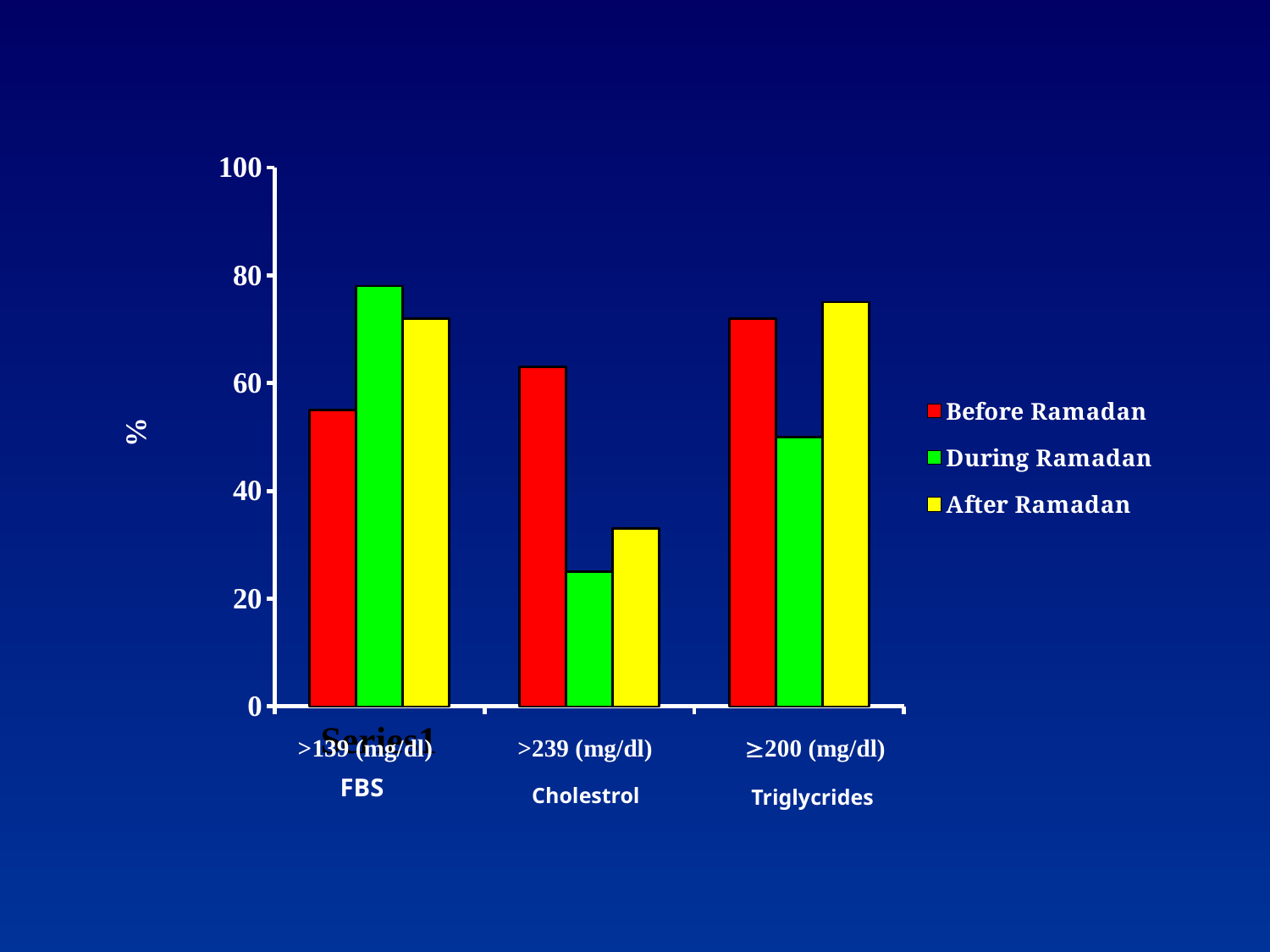
Is the Before Ramadan value for FBS greater or less than 60? less For FBS, which is larger: the Before Ramadan value or the During Ramadan value? During Ramadan For Triglycrides, which series has the lowest value? During Ramadan Is the During Ramadan value for Cholestrol greater or less than 40? less Is the After Ramadan value for Triglycrides greater or less than 60? greater What colour represents the After Ramadan series in the legend? yellow What kind of chart is shown on the slide? bar chart How many categories are shown on the x axis? 3 For Cholestrol, which is larger: the Before Ramadan value or the After Ramadan value? Before Ramadan How many series does the legend list? 3 For Cholestrol, which series has the highest value? Before Ramadan